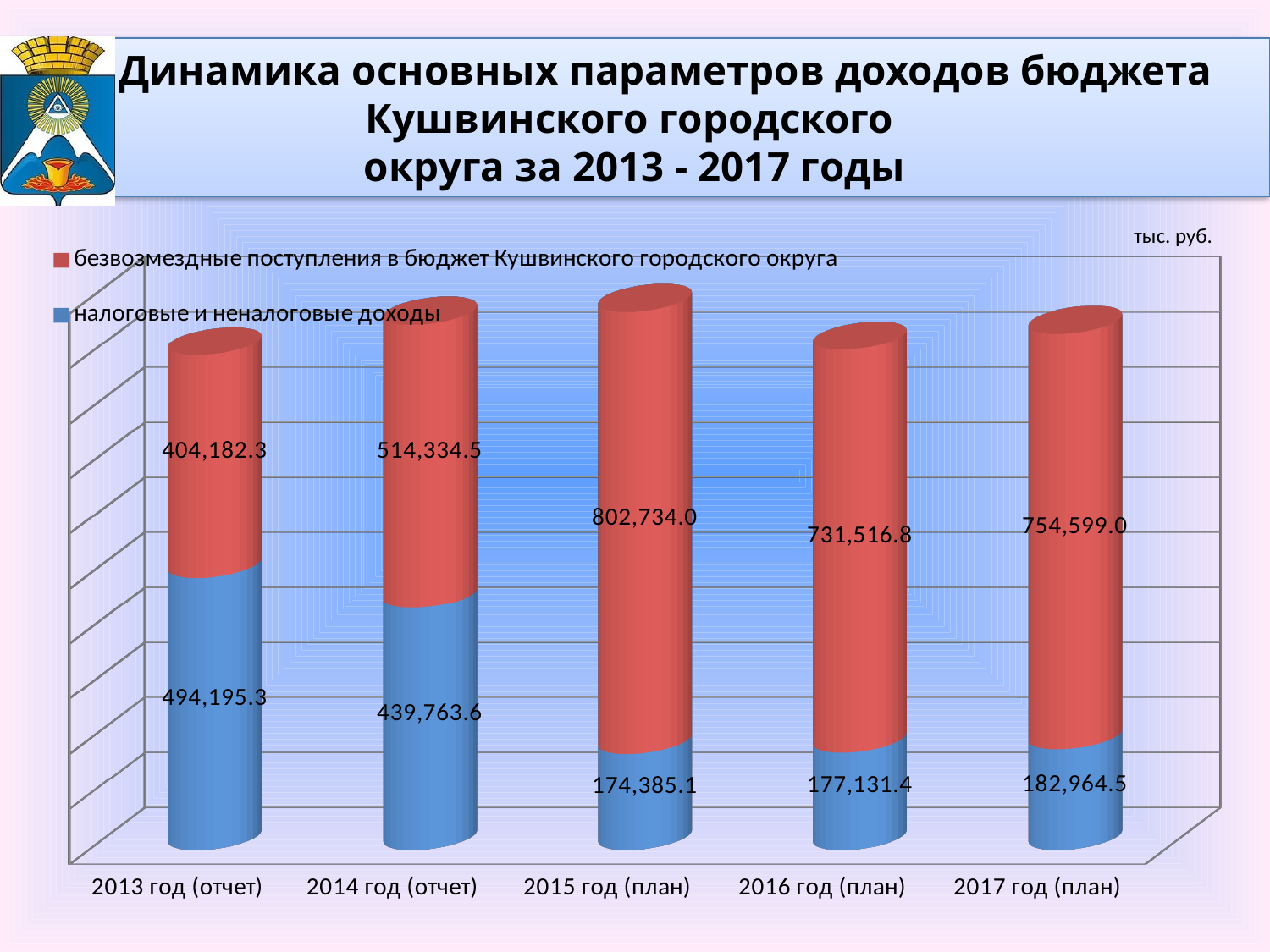
What is the total of the stacked bar for 2013 год (отчет)? 898,377.6 What is the value of безвозмездные поступления for 2015 год (план)? 802,734.0 In which year is the value of безвозмездные поступления the highest? 2015 год (план) What type of chart is shown on the slide? stacked bar chart Which is larger in 2013 год (отчет): безвозмездные поступления or налоговые и неналоговые доходы? налоговые и неналоговые доходы What is the difference between безвозмездные поступления in 2015 год (план) and 2014 год (отчет)? 288,399.5 How many year categories are shown on the x axis? 5 What is the value of налоговые и неналоговые доходы for 2017 год (план)? 182,964.5 How many series does the legend list? 2 What is the value of налоговые и неналоговые доходы for 2014 год (отчет)? 439,763.6 What unit is indicated in the top right corner of the chart? тыс. руб. In which year is the value of налоговые и неналоговые доходы the lowest? 2015 год (план)